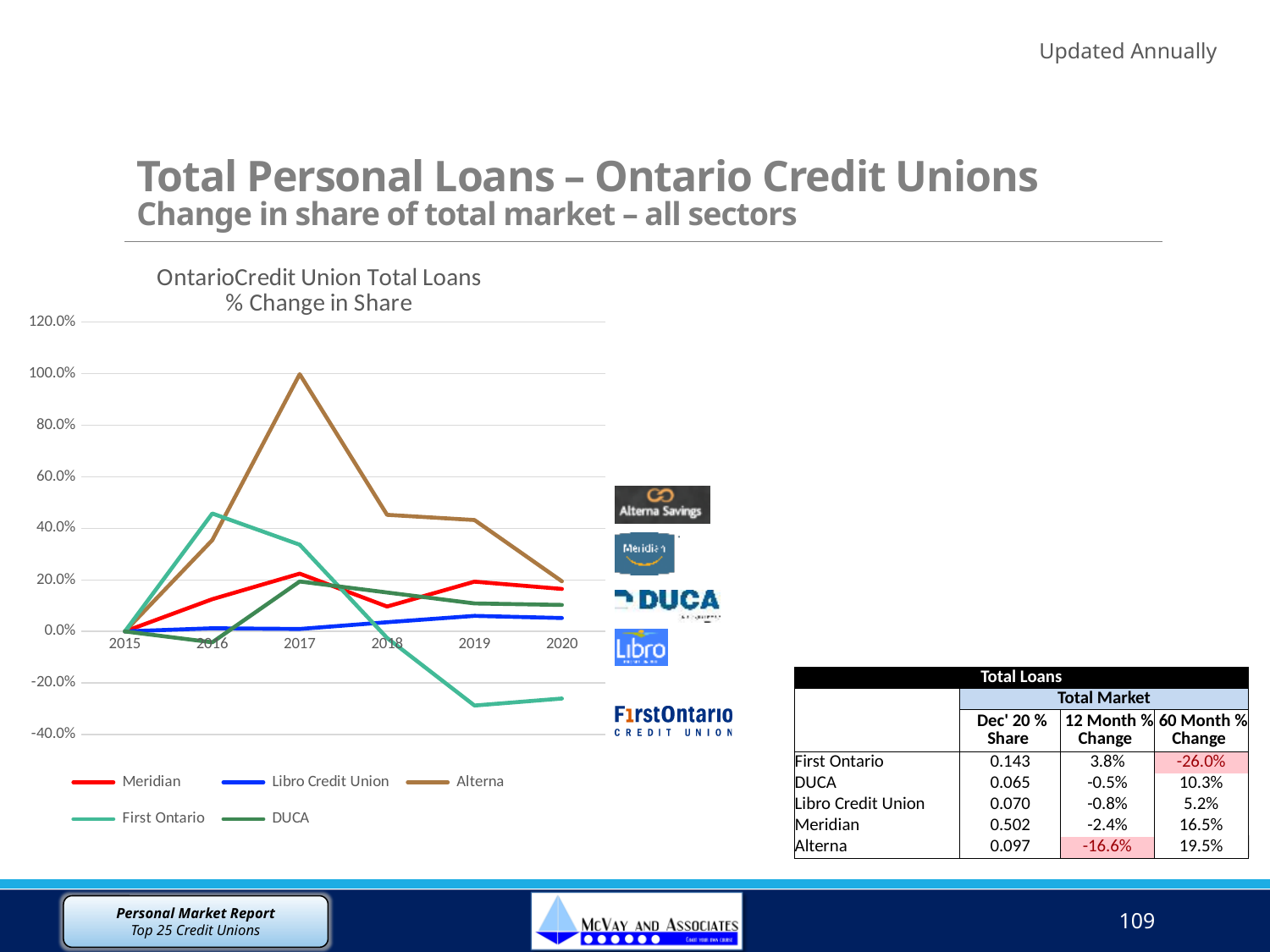
Which series has the highest value in 2016? First Ontario Is the value for First Ontario in 2019 greater or less than -20.0%? less Which series has the lowest value in 2019? First Ontario How many series does the chart legend list? 5 Does the Alterna line rise or fall from 2017 to 2020? fall Is the value for Alterna in 2020 greater or less than 40.0%? less Is the value for Alterna in 2017 greater or less than 80.0%? greater In 2020, which is larger: the value for Meridian or the value for Libro Credit Union? Meridian What is the title of the chart? OntarioCredit Union Total Loans % Change in Share What kind of chart is shown on the slide? line chart Which series has the highest value in 2017? Alterna How many years are plotted along the x axis of the chart? 6